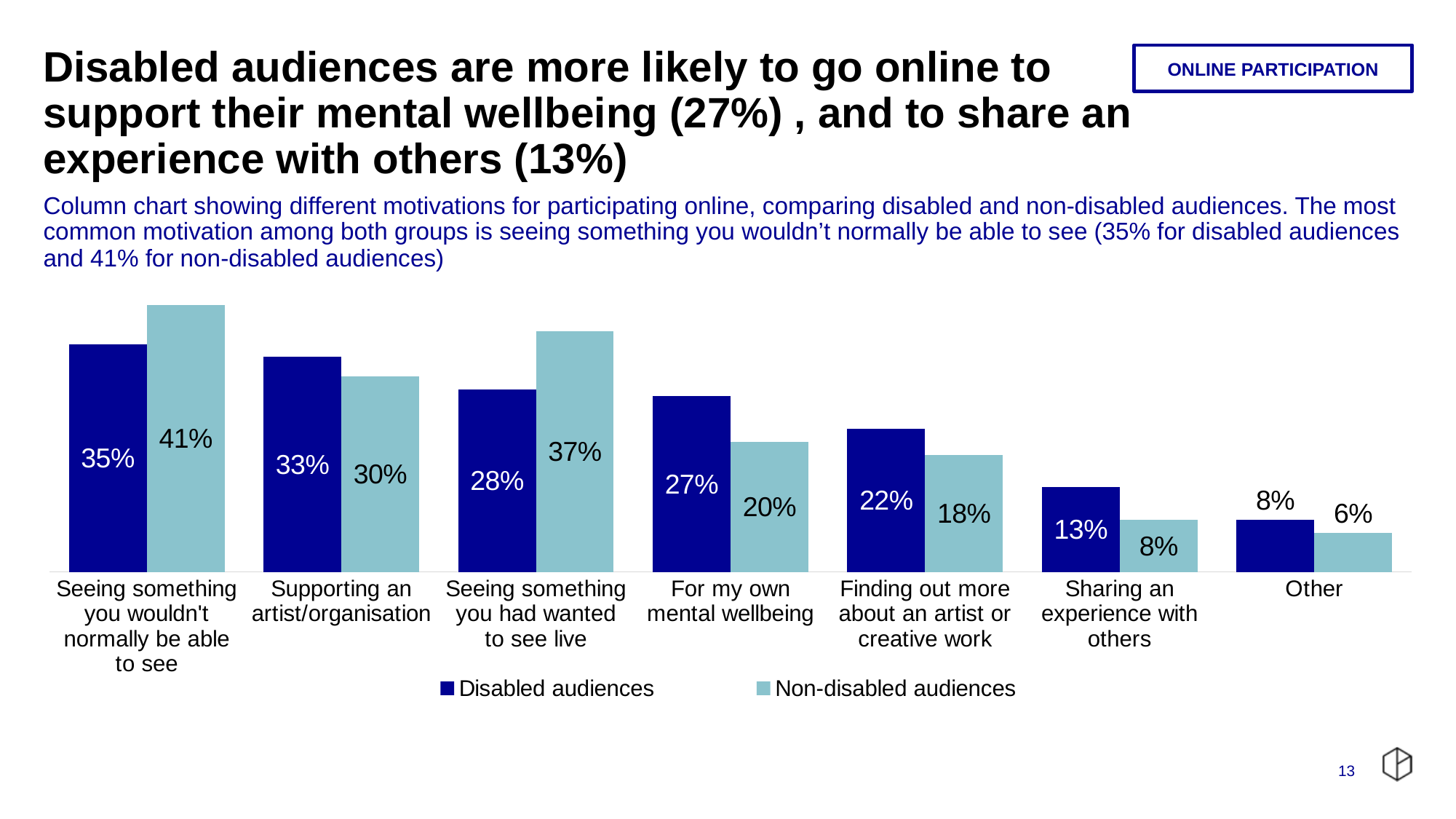
What is the difference between Disabled audiences and Non-disabled audiences for 'Sharing an experience with others'? 5% What kind of chart is shown on the slide? Bar chart What is the difference between Non-disabled and Disabled audiences for 'Seeing something you had wanted to see live'? 9% Which category has the lowest value for Disabled audiences? Other What is the value for Non-disabled audiences for 'Seeing something you had wanted to see live'? 37% Which colour represents Non-disabled audiences in the chart? Light blue How many series does the legend list? 2 How many categories are shown on the x axis? 7 What is the value for Non-disabled audiences for 'Finding out more about an artist or creative work'? 18% For 'Supporting an artist/organisation', which series has the larger value? Disabled audiences What is the value for Disabled audiences for 'For my own mental wellbeing'? 27% Which category has the highest value for Non-disabled audiences? Seeing something you wouldn't normally be able to see